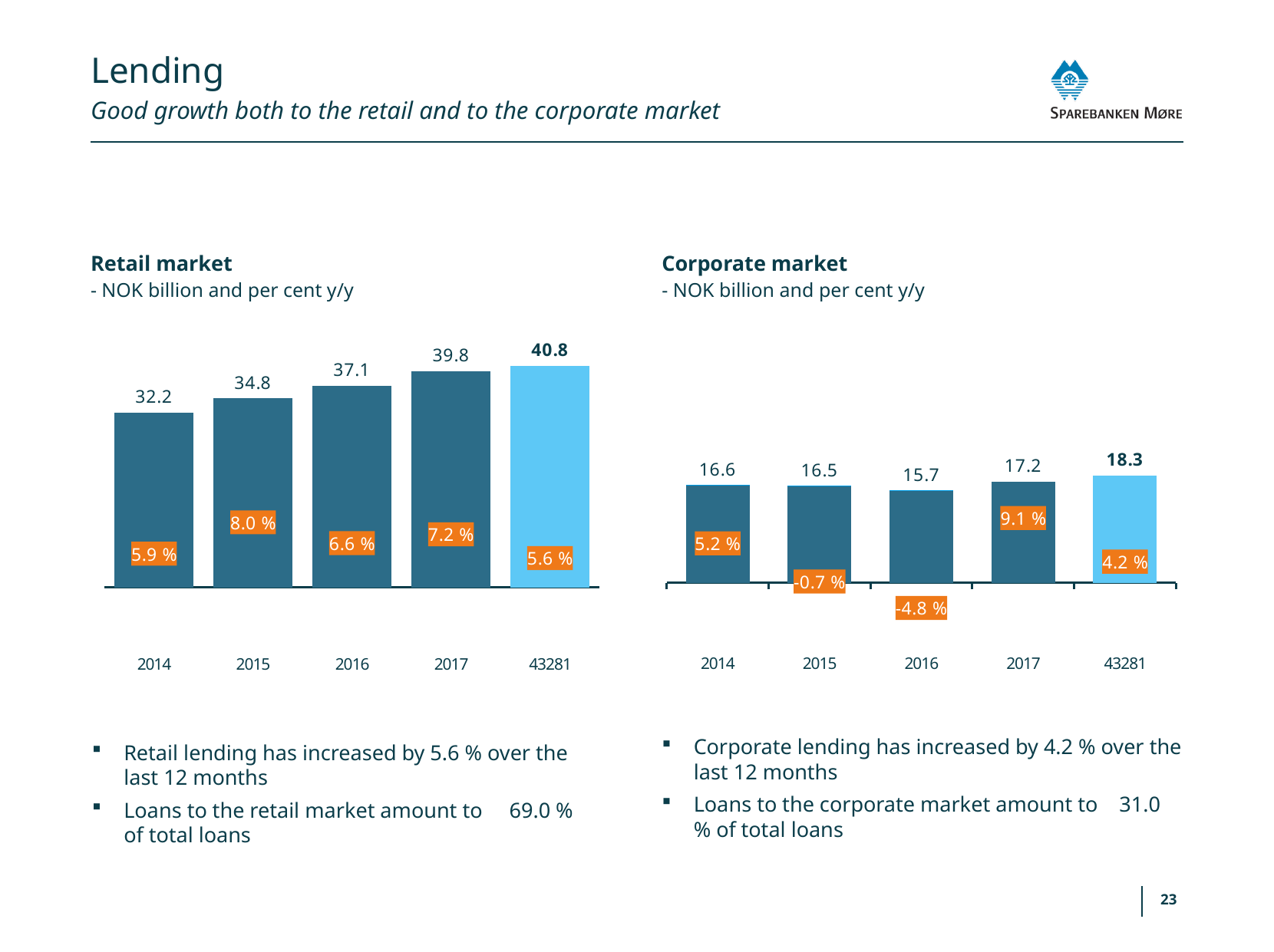
In the Corporate market chart, which year has the lowest value? 2016 What kind of chart is the Corporate market chart? Bar chart How many bars are in the Retail market chart? 5 In the Corporate market chart, what is the growth percentage shown for 2016? -4.8 % In the Retail market chart, what is the growth percentage shown for 2015? 8.0 % In the Corporate market chart, what is the value for 2017? 17.2 In the Retail market chart, which year has the highest value? 43281 In the Retail market chart, what is the value for 2016? 37.1 In the Retail market chart, do the values rise or fall from 2014 to 43281? Rise In the Retail market chart, what is the difference between the values for 2017 and 2014? 7.6 In the Corporate market chart, which is larger, the value for 2014 or the value for 2016? 2014 What is the subtitle shown under the Corporate market chart title? - NOK billion and per cent y/y